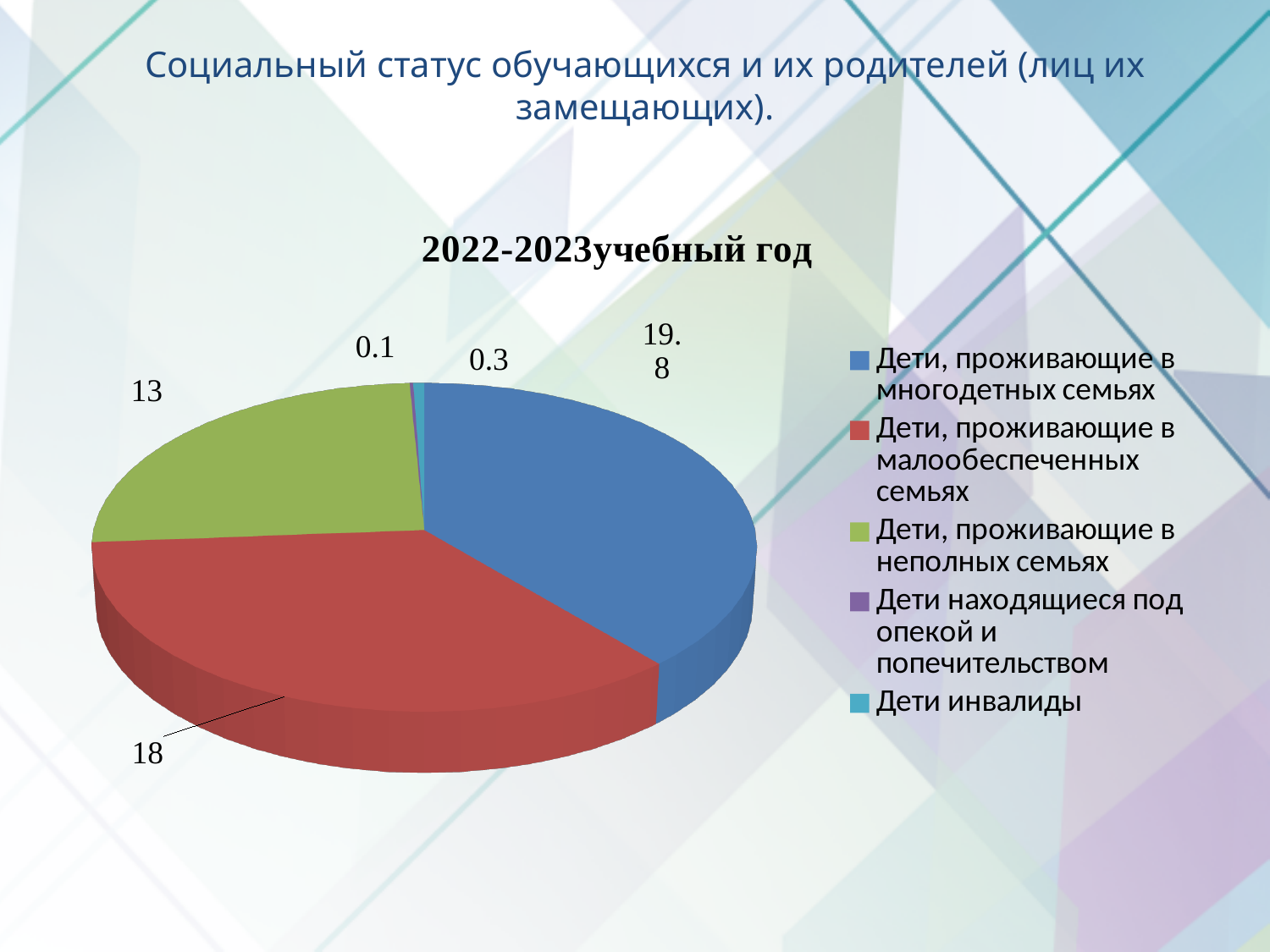
What is the difference between the values for "Дети, проживающие в малообеспеченных семьях" and "Дети, проживающие в неполных семьях"? 5 Which category has the smallest slice of the pie? Дети находящиеся под опекой и попечительством Which category has the largest slice of the pie? Дети, проживающие в многодетных семьях Which is larger: the value for "Дети, проживающие в многодетных семьях" or for "Дети, проживающие в неполных семьях"? Дети, проживающие в многодетных семьях How many categories does the legend of the pie chart list? 5 What colour is the slice for "Дети, проживающие в неполных семьях"? green What is the value for "Дети инвалиды"? 0.3 What is the value for "Дети, проживающие в малообеспеченных семьях"? 18 What is the value for "Дети, проживающие в неполных семьях"? 13 What kind of chart is shown on the slide? pie chart What is the title of the chart? 2022-2023учебный год What is the value for "Дети, проживающие в многодетных семьях"? 19.8